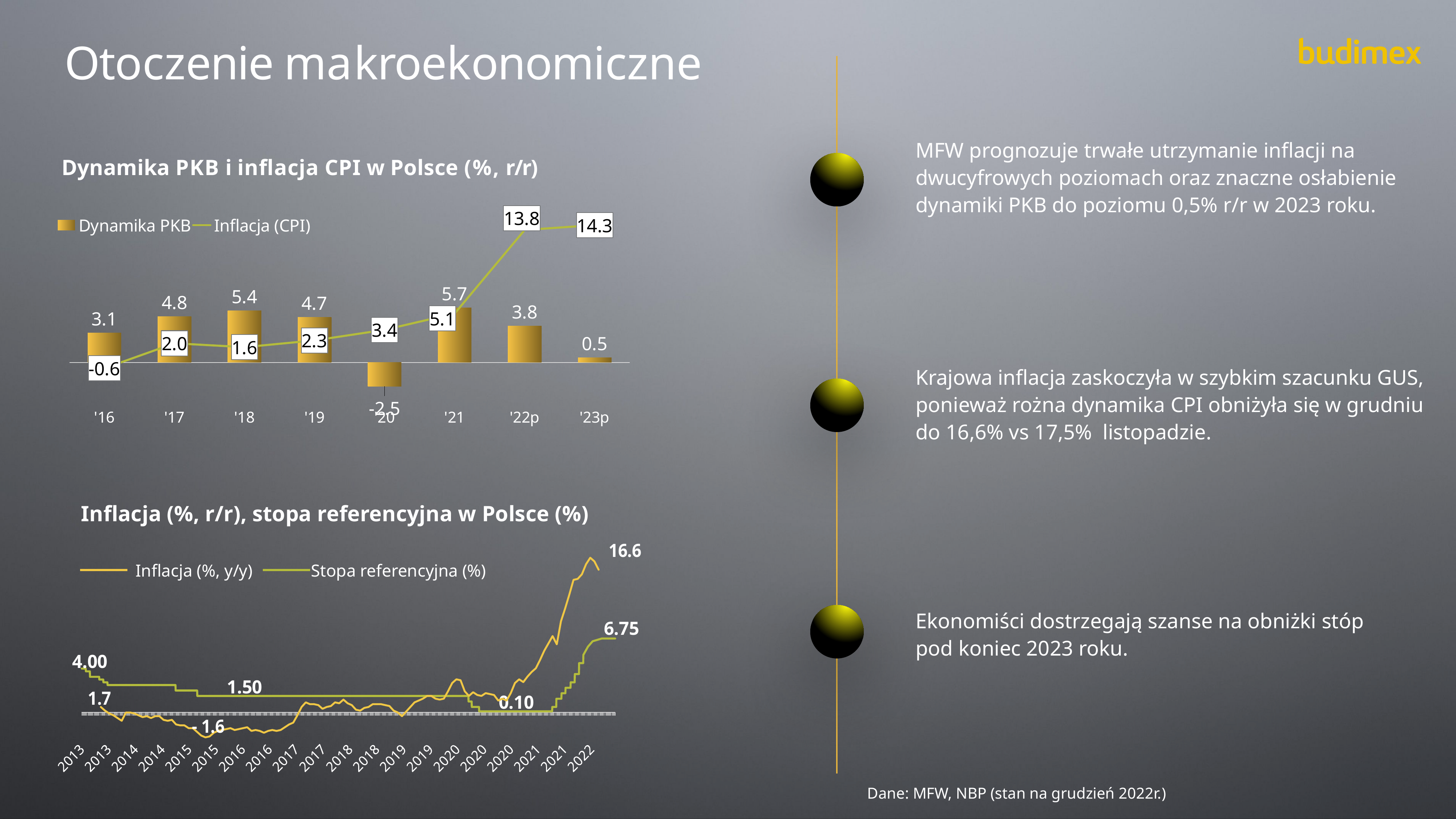
In the chart 'Inflacja (%, r/r), stopa referencyjna w Polsce (%)', what is the last labelled value of the Inflacja (%, y/y) line in 2022? 16.6 In the chart 'Dynamika PKB i inflacja CPI w Polsce (%, r/r)', how many years are shown on the x axis? 8 In the chart 'Dynamika PKB i inflacja CPI w Polsce (%, r/r)', what is the difference between the Inflacja (CPI) values for '23p and '22p? 0.5 What kind of chart is 'Inflacja (%, r/r), stopa referencyjna w Polsce (%)'? line chart In the chart 'Dynamika PKB i inflacja CPI w Polsce (%, r/r)', how many series does the legend list? 2 In the chart 'Inflacja (%, r/r), stopa referencyjna w Polsce (%)', what is the last labelled value of the Stopa referencyjna (%) line? 6.75 In the chart 'Dynamika PKB i inflacja CPI w Polsce (%, r/r)', does the Inflacja (CPI) line rise or fall from '20 to '23p? rise In the chart 'Dynamika PKB i inflacja CPI w Polsce (%, r/r)', which is larger for '19: Dynamika PKB or Inflacja (CPI)? Dynamika PKB In the chart 'Dynamika PKB i inflacja CPI w Polsce (%, r/r)', which year has the lowest Dynamika PKB value? '20 In the chart 'Dynamika PKB i inflacja CPI w Polsce (%, r/r)', what is the Inflacja (CPI) value for '22p? 13.8 In the chart 'Dynamika PKB i inflacja CPI w Polsce (%, r/r)', which year has the highest Dynamika PKB value? '21 In the chart 'Dynamika PKB i inflacja CPI w Polsce (%, r/r)', what is the value of Dynamika PKB for '18? 5.4